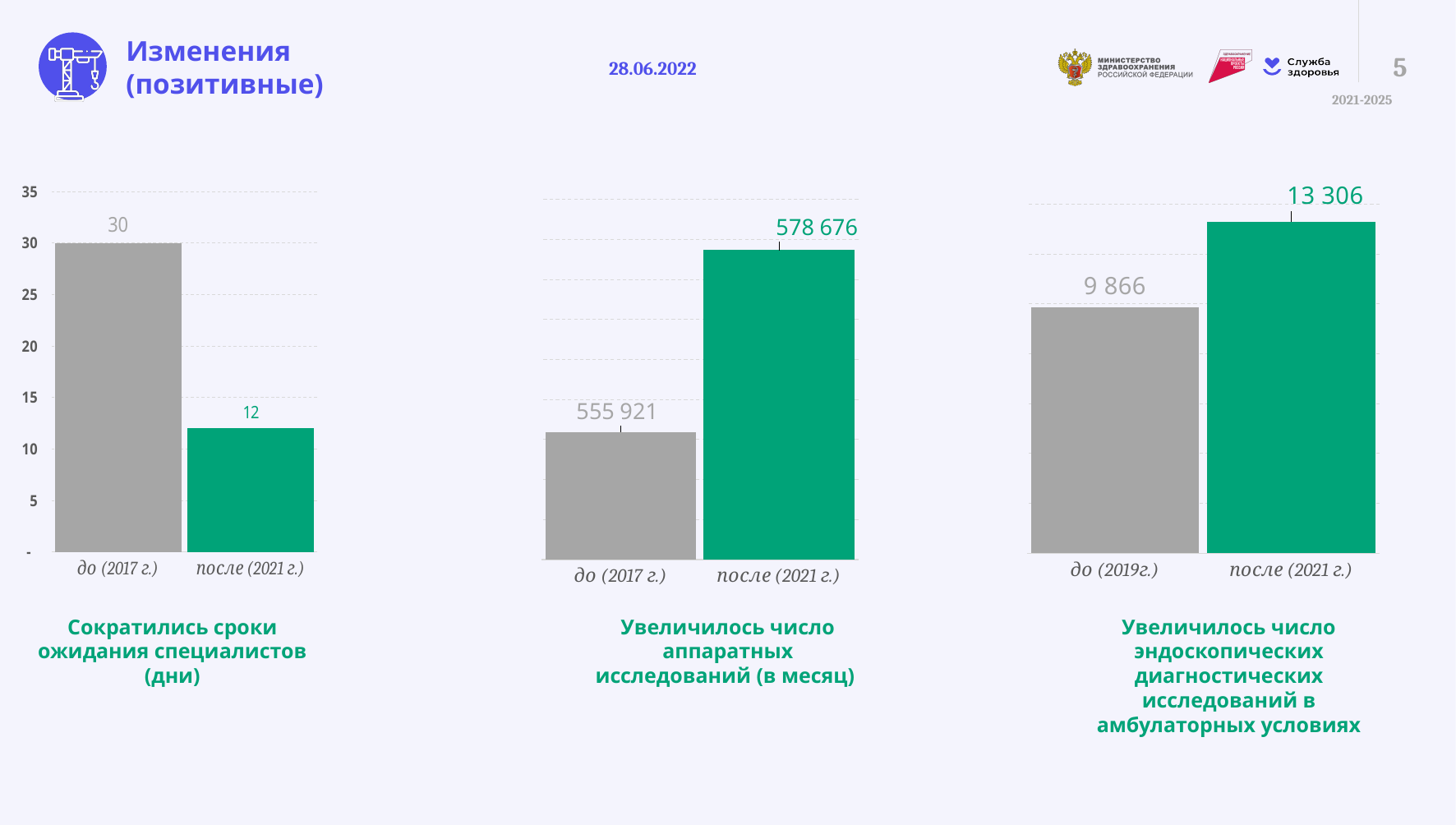
In the middle chart (Увеличилось число аппаратных исследований), what is the difference between 'после (2021 г.)' and 'до (2017 г.)'? 22 755 In the right chart (Увеличилось число эндоскопических диагностических исследований), what is the value for 'после (2021 г.)'? 13 306 How many bars does the middle chart (Увеличилось число аппаратных исследований) have? 2 What type of chart is the left chart (Сократились сроки ожидания специалистов)? bar chart In the right chart (Увеличилось число эндоскопических диагностических исследований), what is the difference between 'после (2021 г.)' and 'до (2019г.)'? 3 440 In the middle chart (Увеличилось число аппаратных исследований), what is the value for 'до (2017 г.)'? 555 921 In the left chart (Сократились сроки ожидания специалистов), by how much did the value decrease from 'до (2017 г.)' to 'после (2021 г.)'? 18 In the left chart (Сократились сроки ожидания специалистов), what is the value for 'после (2021 г.)'? 12 In the middle chart (Увеличилось число аппаратных исследований), what is the value for 'после (2021 г.)'? 578 676 In the right chart (Увеличилось число эндоскопических диагностических исследований), what is the value for 'до (2019г.)'? 9 866 In the left chart (Сократились сроки ожидания специалистов), what is the value for 'до (2017 г.)'? 30 In the right chart (Увеличилось число эндоскопических диагностических исследований), which category has the higher value? после (2021 г.)